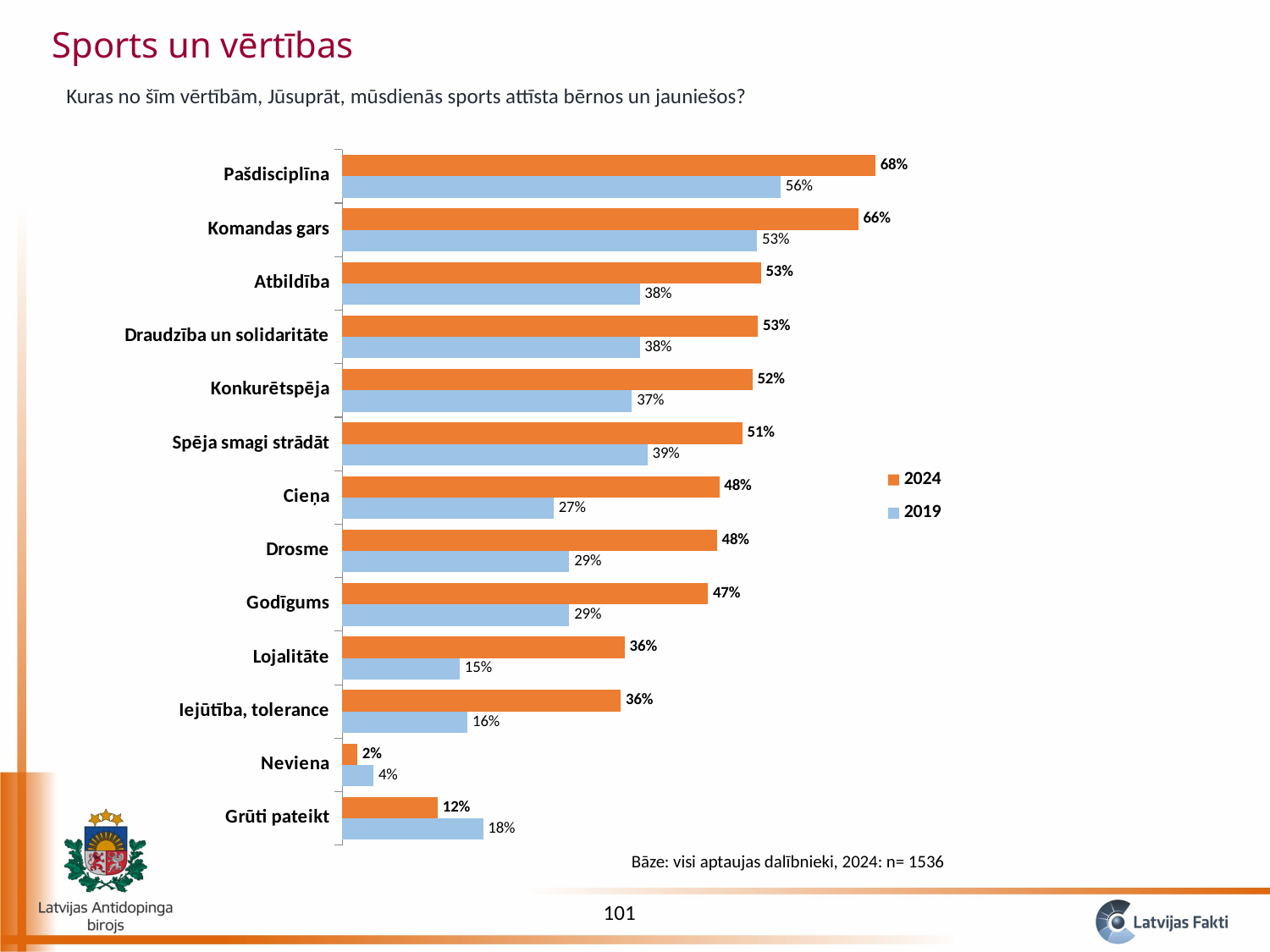
What is the difference between the 2024 and 2019 values for Lojalitāte? 21% How many categories are shown on the chart? 13 What is the 2019 value for Lojalitāte? 15% Which category has the lowest 2024 value? Neviena What is the 2019 value for Cieņa? 27% What is the difference between the 2024 and 2019 values for Atbildība? 15% What kind of chart is shown on the slide? Bar chart What is the 2024 value for Pašdisciplīna? 68% How many series does the legend list? 2 Which is larger, the 2019 value for Komandas gars or the 2019 value for Spēja smagi strādāt? Komandas gars Which is larger for Grūti pateikt, the 2024 value or the 2019 value? 2019 Which category has the highest 2024 value? Pašdisciplīna